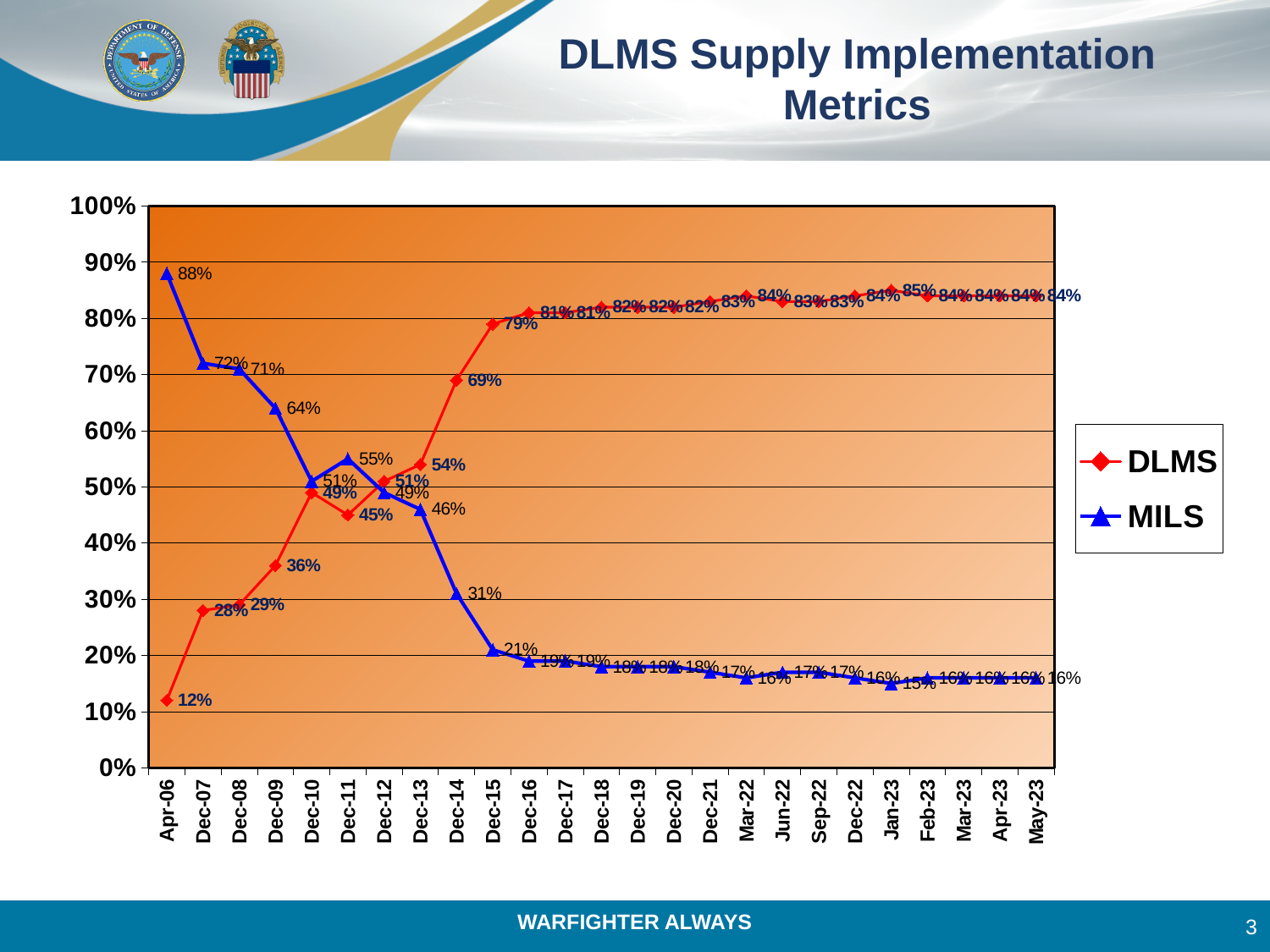
What is the DLMS value for Apr-06? 12% What is the MILS value for Apr-06? 88% How many series does the legend list? 2 At Dec-11, which series has the larger value, DLMS or MILS? MILS Does the MILS series generally rise or fall from Apr-06 to May-23? Fall At which date does the MILS series reach its lowest value? Jan-23 How many dates are shown on the x axis? 25 What is the DLMS value for Dec-14? 69% What kind of chart is shown on the slide? Line chart What is the MILS value for Dec-15? 21% At which date does the DLMS series reach its highest value? Jan-23 What is the difference between the DLMS and MILS values at Dec-15? 58 percentage points